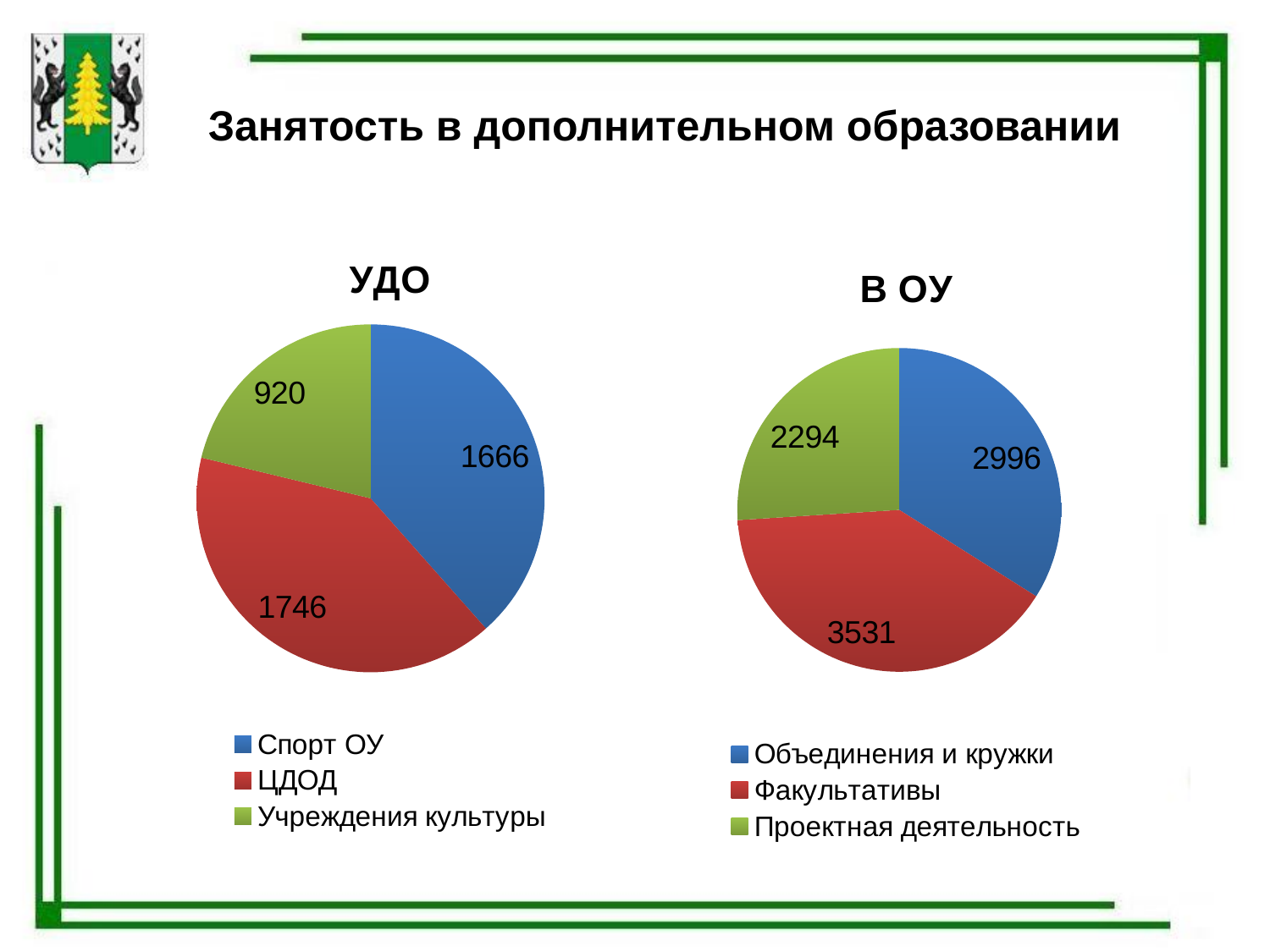
On the В ОУ chart, which category has the smallest value? Проектная деятельность On the УДО chart, what is the value for Учреждения культуры? 920 On the В ОУ chart, what is the value for Факультативы? 3531 On the В ОУ chart, what is the value for Проектная деятельность? 2294 How many slices does the В ОУ chart have? 3 What is the title of the slide? Занятость в дополнительном образовании On the В ОУ chart, what is the difference between Факультативы and Объединения и кружки? 535 On the УДО chart, what is the total of all three slices? 4332 On the УДО chart, what is the value for ЦДОД? 1746 What type of chart is the УДО chart? pie chart On the УДО chart, which is larger: Спорт ОУ or ЦДОД? ЦДОД On the УДО chart, which category has the largest value? ЦДОД